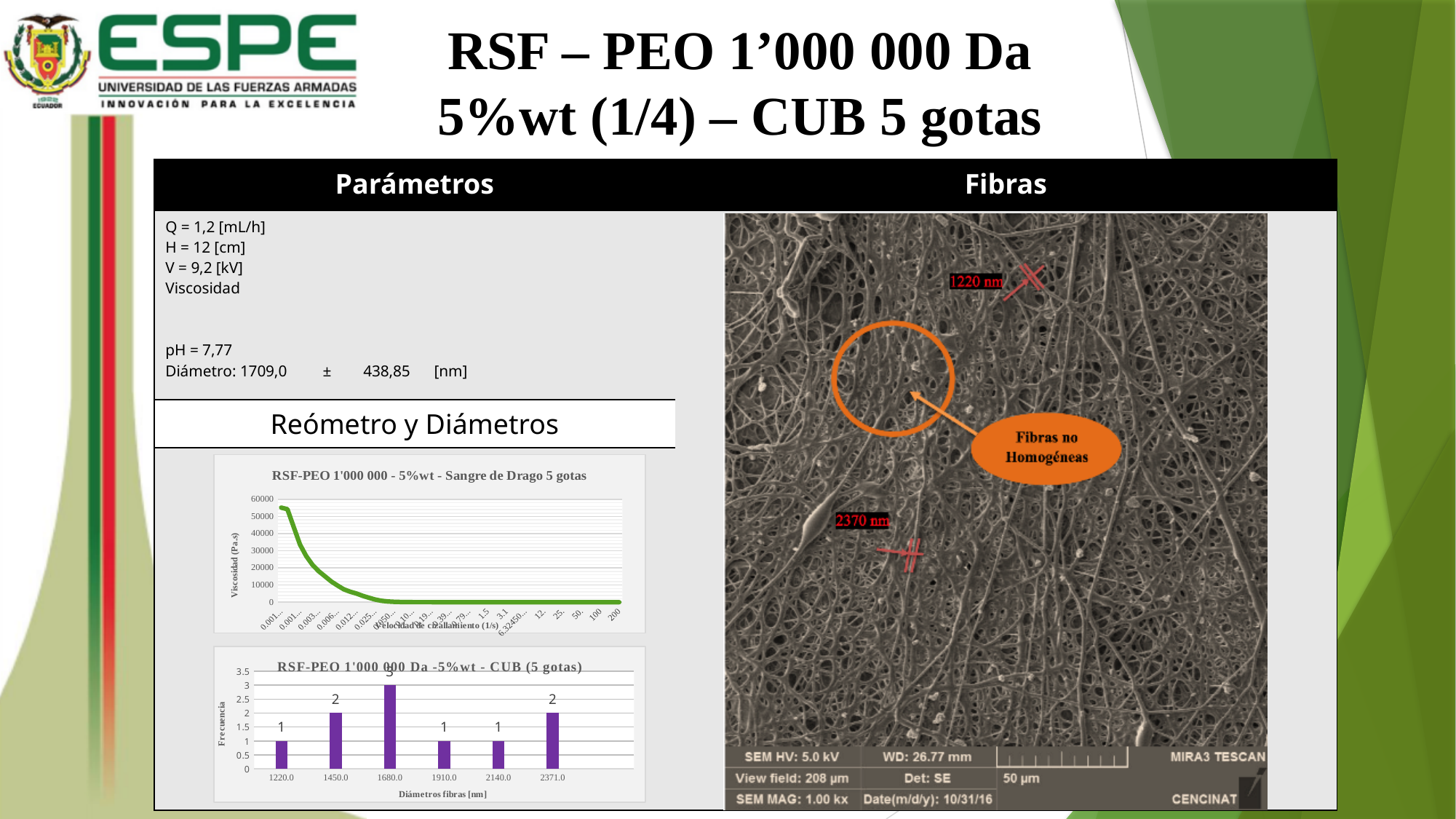
In the line chart titled "RSF-PEO 1'000 000 - 5%wt - Sangre de Drago 5 gotas", does the viscosity rise or fall as the shear rate increases along the x axis? fall In the bar chart titled "RSF-PEO 1'000 000 Da -5%wt - CUB (5 gotas)", what is the total of all the frequencies shown? 10 In the bar chart titled "RSF-PEO 1'000 000 Da -5%wt - CUB (5 gotas)", how many diameter categories are shown on the x axis? 6 In the bar chart titled "RSF-PEO 1'000 000 Da -5%wt - CUB (5 gotas)", what is the frequency for the 2371.0 nm diameter? 2 In the bar chart titled "RSF-PEO 1'000 000 Da -5%wt - CUB (5 gotas)", which has a larger frequency, 1450.0 or 1910.0? 1450.0 In the line chart titled "RSF-PEO 1'000 000 - 5%wt - Sangre de Drago 5 gotas", what is the label of the y axis? Viscosidad (Pa.s) In the bar chart titled "RSF-PEO 1'000 000 Da -5%wt - CUB (5 gotas)", which diameter category has the highest frequency? 1680.0 In the bar chart titled "RSF-PEO 1'000 000 Da -5%wt - CUB (5 gotas)", what is the difference between the frequency at 1680.0 and the frequency at 1220.0? 2 What kind of chart is the lower chart on the left, titled "RSF-PEO 1'000 000 Da -5%wt - CUB (5 gotas)"? bar chart In the bar chart titled "RSF-PEO 1'000 000 Da -5%wt - CUB (5 gotas)", what is the frequency for the 1680.0 nm diameter? 3 In the bar chart titled "RSF-PEO 1'000 000 Da -5%wt - CUB (5 gotas)", what is the frequency for the 1450.0 nm diameter? 2 What kind of chart is the upper chart on the left, titled "RSF-PEO 1'000 000 - 5%wt - Sangre de Drago 5 gotas"? line chart